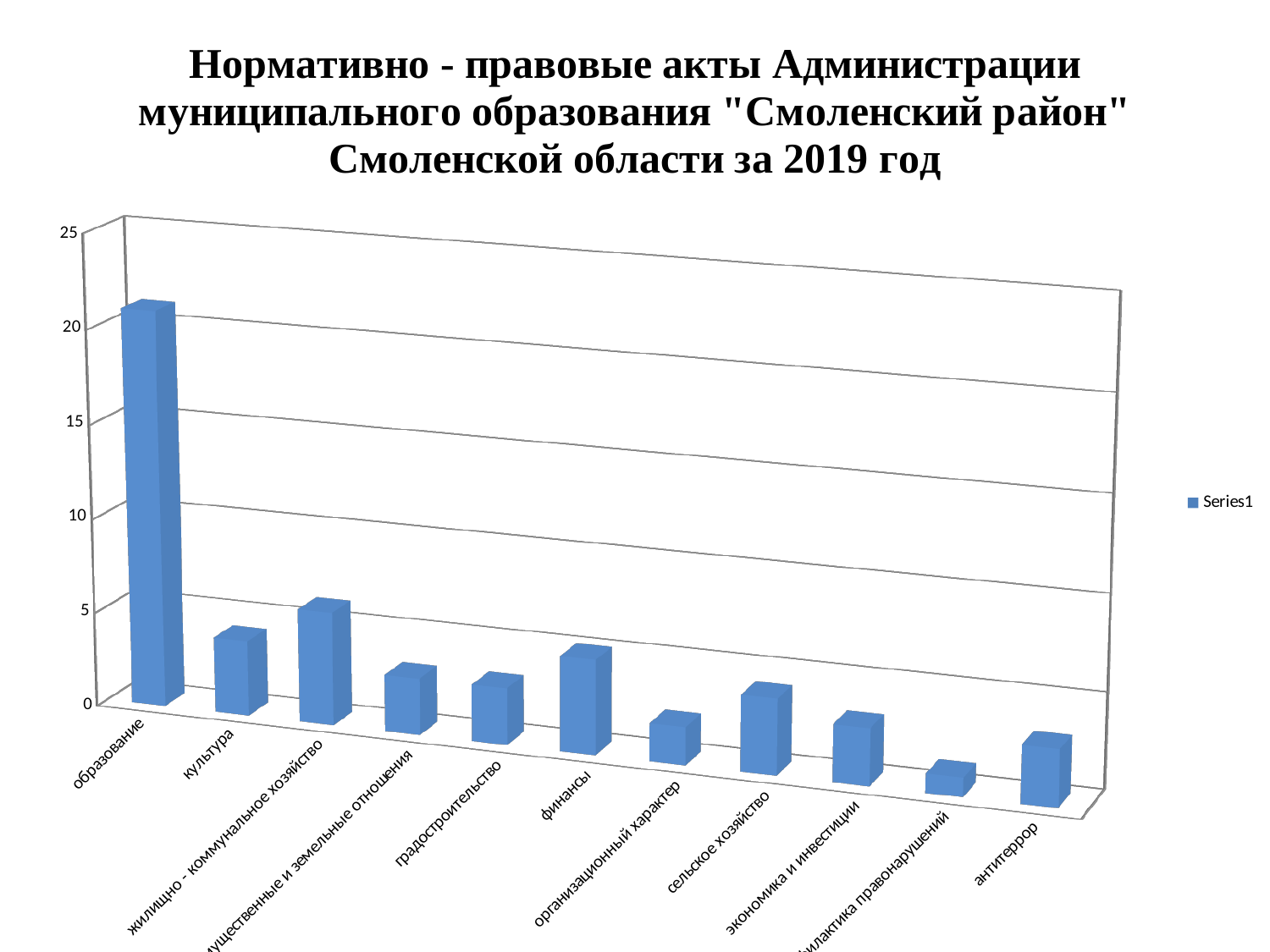
How many categories are plotted along the x axis of the chart? 11 Is the value for финансы greater or less than 10? less Which category has the highest value in the chart? образование What year does the chart title say the data covers? 2019 Which is larger, the value for жилищно - коммунальное хозяйство or the value for организационный характер? жилищно - коммунальное хозяйство How many series does the chart legend list? 1 Is the value for образование greater or less than 15? greater Is the value for жилищно - коммунальное хозяйство greater or less than 10? less What is the legend entry shown for the series in the chart? Series1 What kind of chart is shown on the slide? bar chart Which is larger, the value for образование or the value for культура? образование